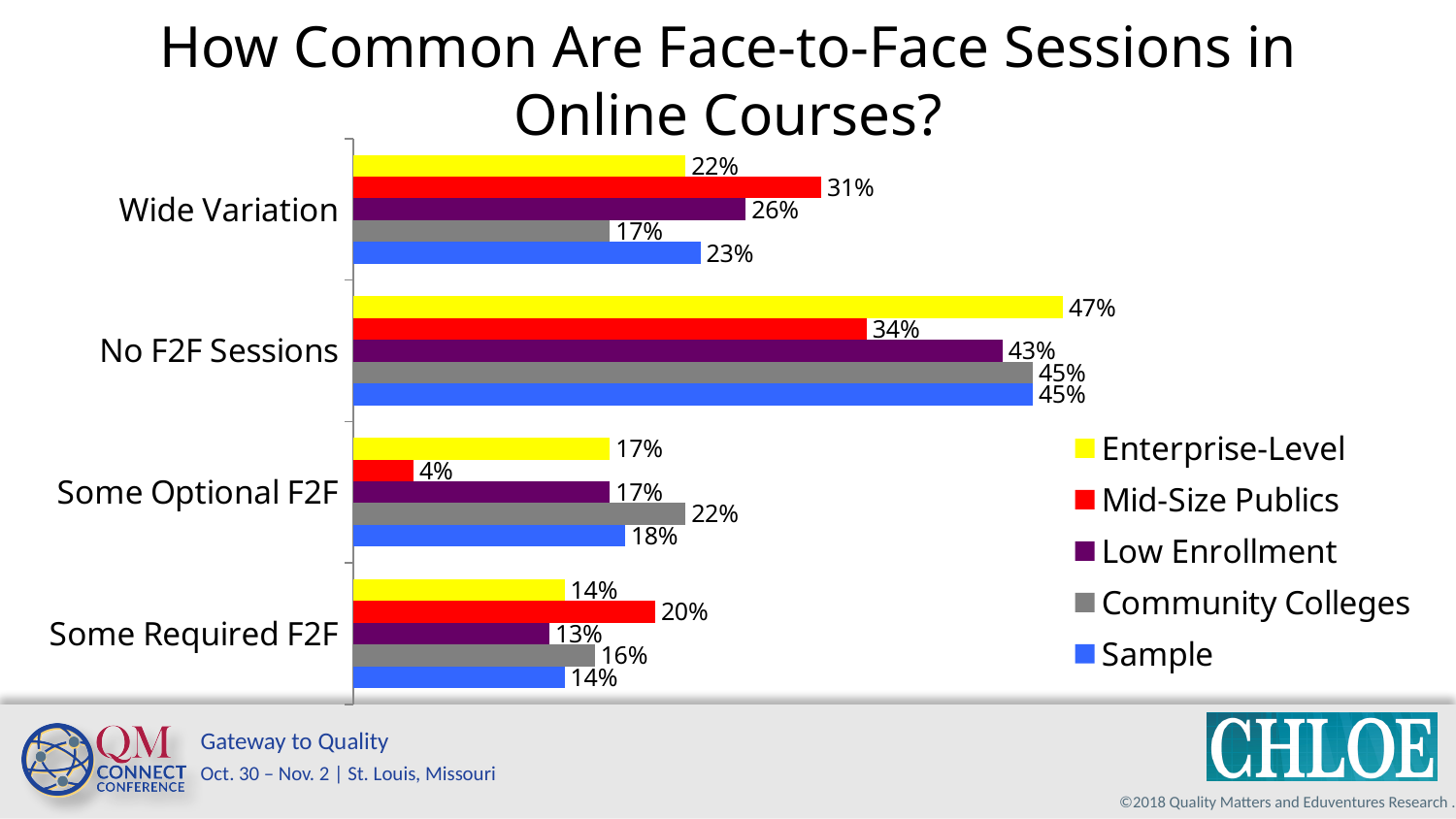
What is the difference between the Enterprise-Level and Mid-Size Publics values in the No F2F Sessions category? 13% Which is larger in the Some Required F2F category: Mid-Size Publics or Low Enrollment? Mid-Size Publics How many categories are shown on the chart? 4 What is the value for Community Colleges in the Wide Variation category? 17% What kind of chart is shown on the slide? Bar chart Which colour represents the Community Colleges series? Gray What is the value for Sample in the Some Required F2F category? 14% What is the value for Mid-Size Publics in the Some Optional F2F category? 4% How many series does the legend list? 5 Which series has the highest value in the Wide Variation category? Mid-Size Publics What is the value for Enterprise-Level in the No F2F Sessions category? 47% Which series has the lowest value in the Some Optional F2F category? Mid-Size Publics